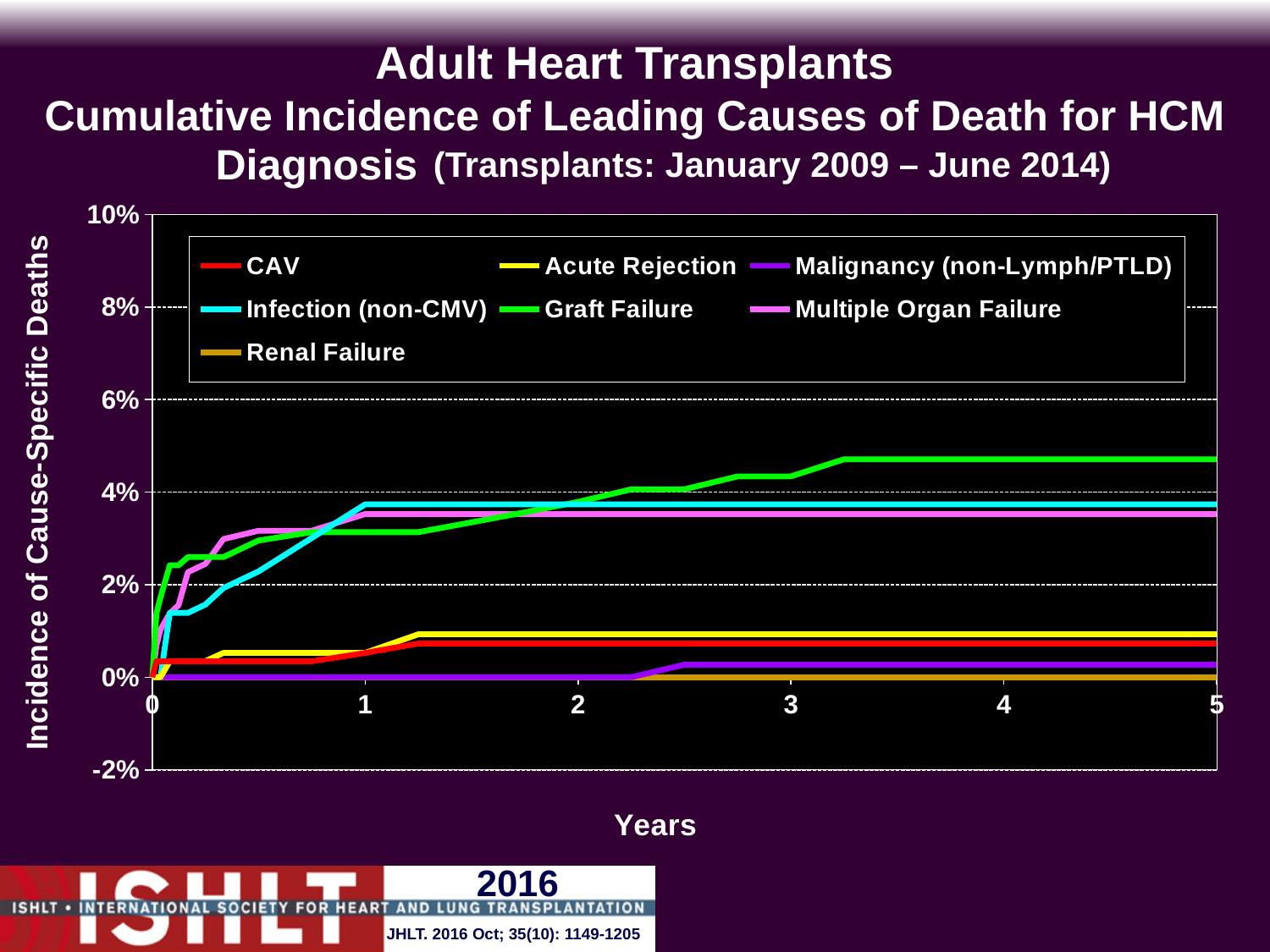
At 5 years, which is larger: the cumulative incidence for Acute Rejection or for Malignancy (non-Lymph/PTLD)? Acute Rejection At 5 years, which is larger: the cumulative incidence for Graft Failure or for Infection (non-CMV)? Graft Failure What kind of chart is shown on the slide? line chart Is the cumulative incidence for Acute Rejection at 5 years greater or less than 2%? less How many series does the legend list? 7 Is the cumulative incidence for Multiple Organ Failure at 5 years greater or less than 2%? greater Is the cumulative incidence for Infection (non-CMV) at 5 years greater or less than 4%? less Which cause of death has the highest cumulative incidence at 5 years? Graft Failure Does the Graft Failure line rise or fall from 0 to 5 years? rise Which cause of death has the lowest cumulative incidence at 5 years? Renal Failure What colour is the Graft Failure line in the chart? green